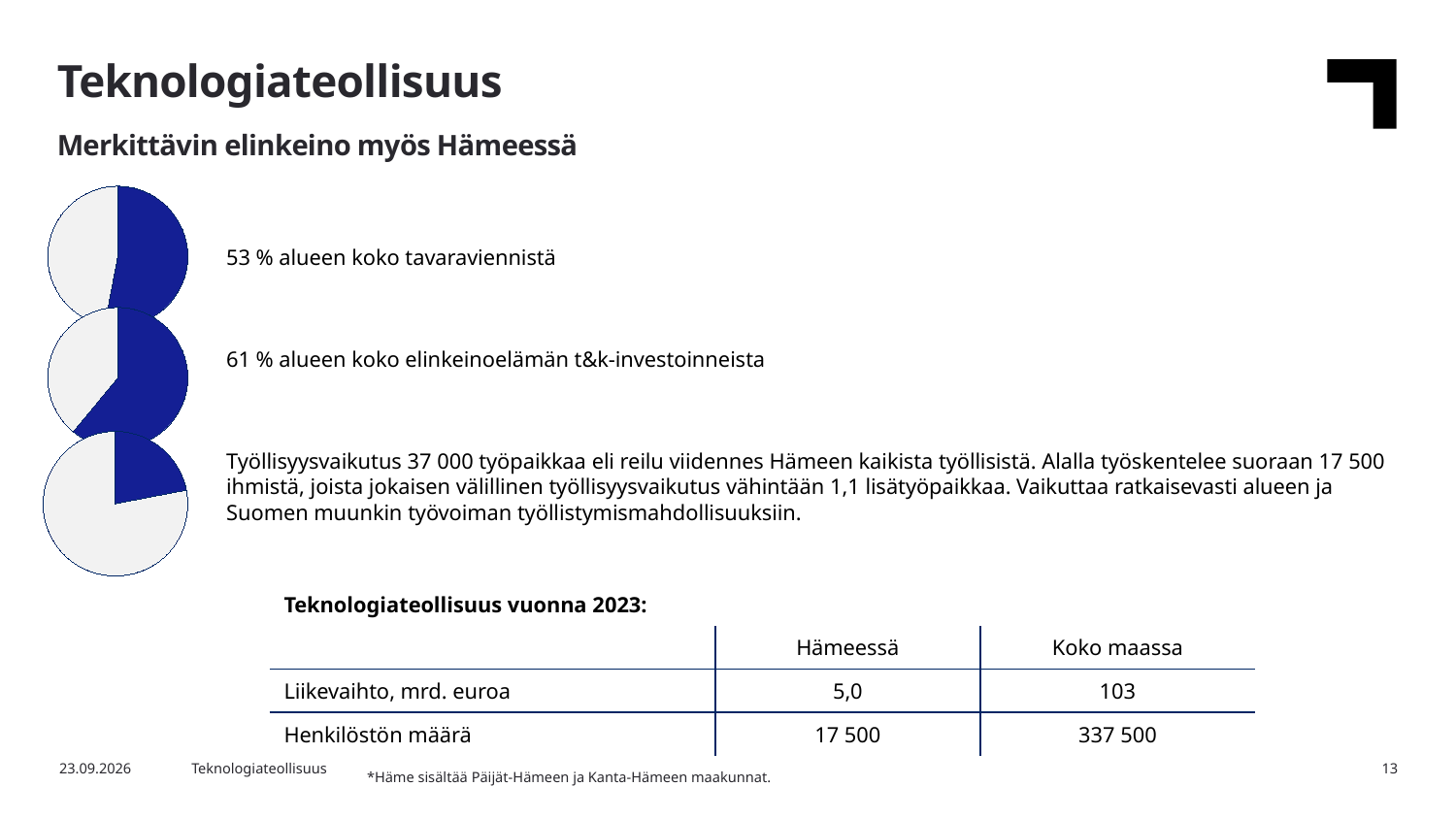
In the bottom pie chart, does the highlighted slice cover more or less than half of the pie? less In the top pie chart, what share of the pie does the highlighted (blue) slice represent? 53 % What is the difference in percentage points between the highlighted shares of the middle pie chart and the top pie chart? 8 percentage points Which pie chart has the larger highlighted slice, the top one or the middle one? the middle one In the middle pie chart, what share of the pie does the highlighted (blue) slice represent? 61 % Of the three pie charts, which one has the smallest highlighted share? the bottom one What does the highlighted slice of the top pie chart represent, according to the text next to it? alueen koko tavaraviennistä How many pie charts are on the slide? 3 Of the three pie charts, which one has the largest highlighted share? the middle one (61 %) Which pie chart has the larger highlighted slice, the top one or the bottom one? the top one What kind of chart is shown at the top left of the slide? pie chart What colour is the highlighted slice in each pie chart? dark blue